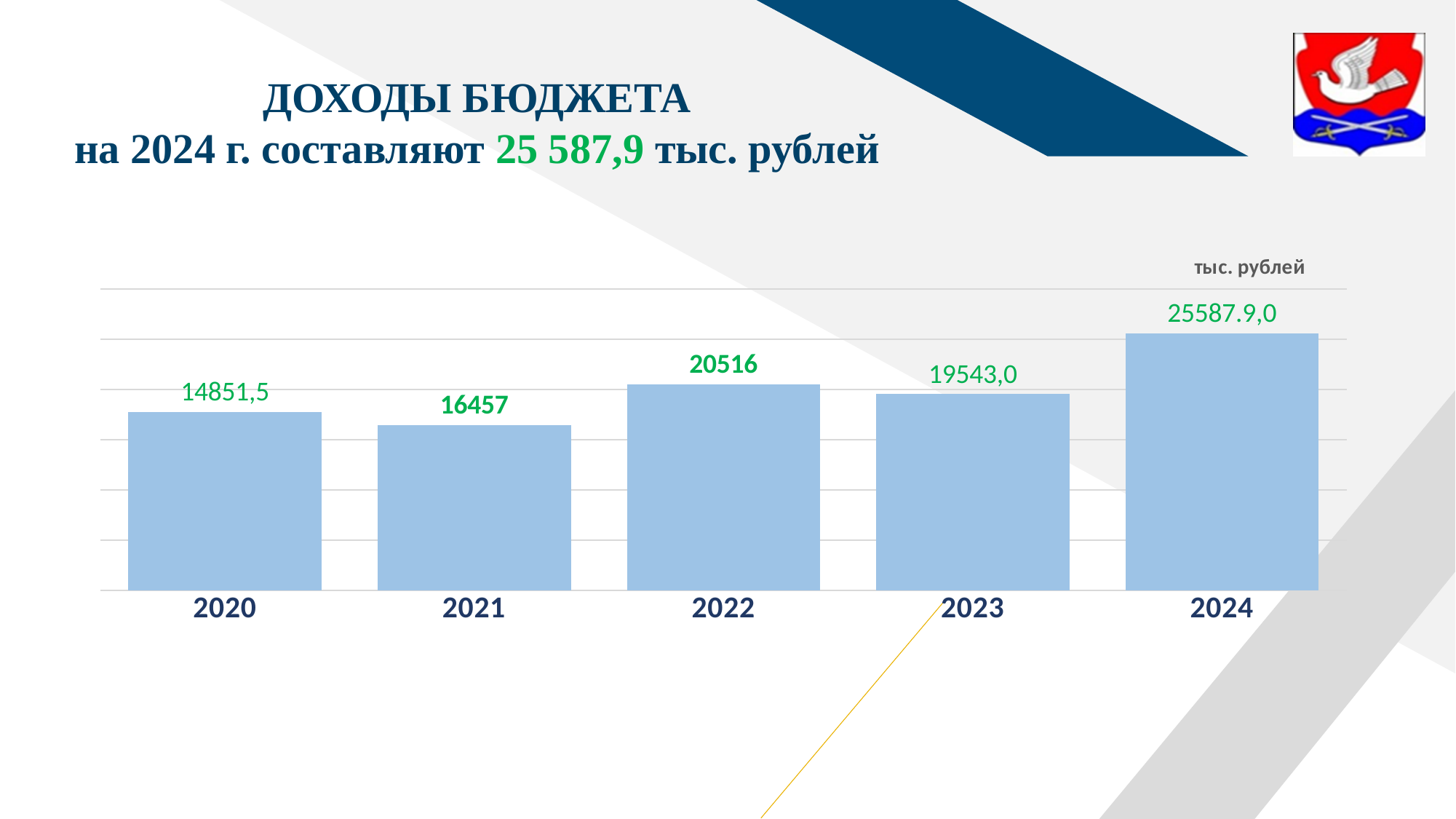
What unit label is shown above the chart? тыс. рублей Which year has the highest value? 2024 What is the value for 2021? 16457 What kind of chart is shown on the slide? bar chart Which is larger, the value for 2022 or the value for 2023? 2022 What is the value for 2022? 20516 What is the data label shown above the 2024 bar? 25587.9,0 How many years are shown on the x axis? 5 What is the difference between the values for 2021 and 2020? 1605,5 What is the value for 2020? 14851,5 What is the value for 2023? 19543,0